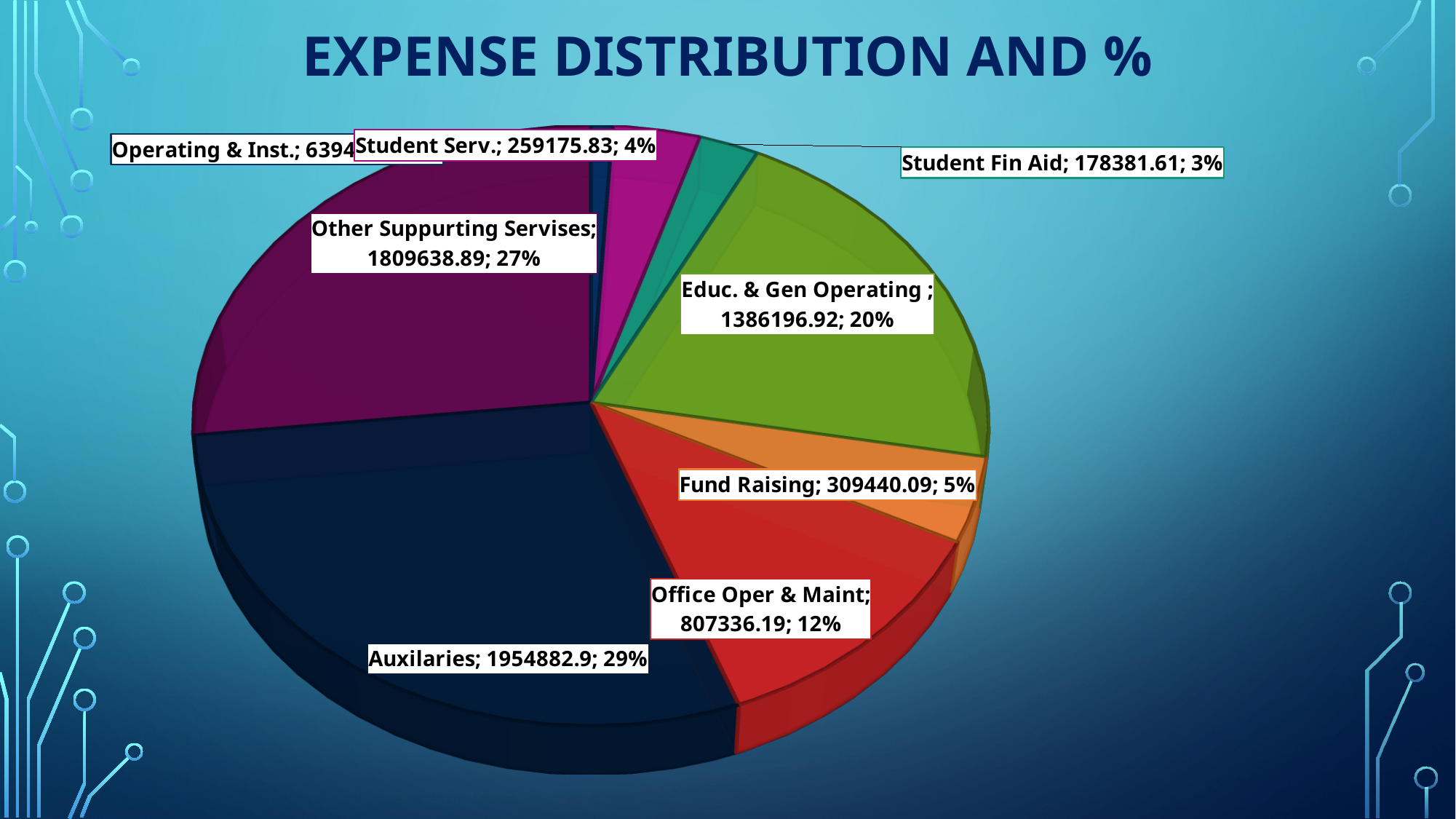
Which category has the largest slice of the pie? Auxilaries How many slices does the pie chart have? 8 What is the value for Auxilaries? 1954882.9 What is the title of the chart? EXPENSE DISTRIBUTION AND % What share of the pie does Other Suppurting Servises represent? 27% What kind of chart is shown on the slide? pie chart What is the value for Student Fin Aid? 178381.61 What is the value for Fund Raising? 309440.09 What is the value for Educ. & Gen Operating? 1386196.92 Which is larger, Student Serv. or Student Fin Aid? Student Serv. What is the difference between the values for Auxilaries and Other Suppurting Servises? 145244.01 What share of the pie does Office Oper & Maint represent? 12%